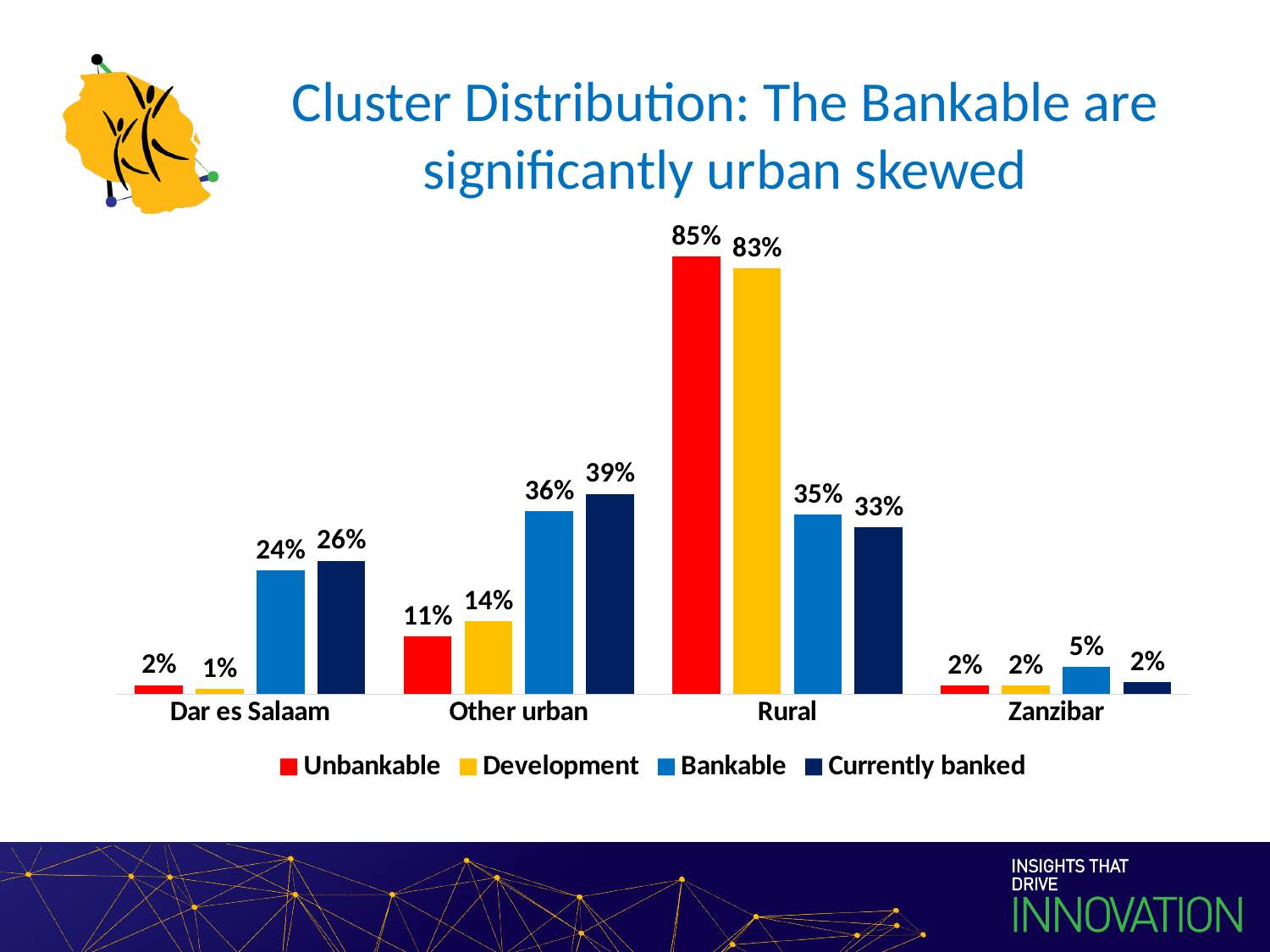
Which colour represents the Development series? Yellow What is the difference between the Unbankable and Bankable values in Rural? 50% What is the value for Development in Rural? 83% Which is larger in Other urban: Development or Currently banked? Currently banked What is the value for Currently banked in Dar es Salaam? 26% Which category has the highest value for Unbankable? Rural How many categories are shown on the x axis? 4 What kind of chart is shown on the slide? Bar chart What is the value for Unbankable in Zanzibar? 2% What is the value for Bankable in Other urban? 36% Which category has the lowest value for Development? Dar es Salaam How many series does the legend list? 4